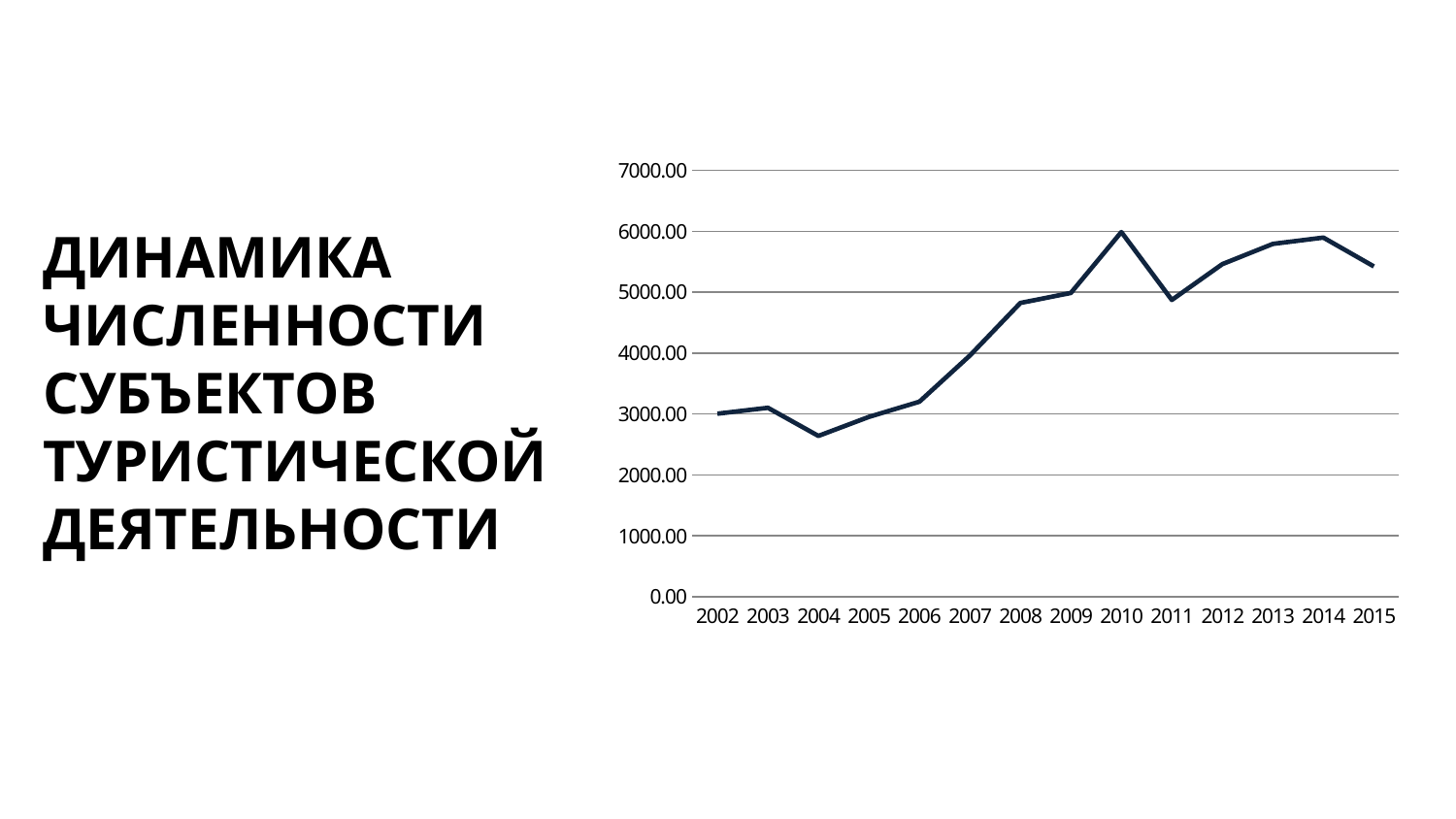
Is the value for 2008 greater or less than 4000? greater Is the value for 2006 greater or less than 4000? less Which is larger, the value for 2010 or the value for 2011? 2010 Which year has the lowest value on the chart? 2004 Which is larger, the value for 2004 or the value for 2008? 2008 What kind of chart is shown on the slide? line chart What is the highest tick value shown on the vertical axis of the chart? 7000.00 Is the value for 2010 greater or less than 5000? greater Which year has the highest value on the chart? 2010 Do the values generally rise or fall from 2004 to 2010? rise How many years are plotted along the x axis of the chart? 14